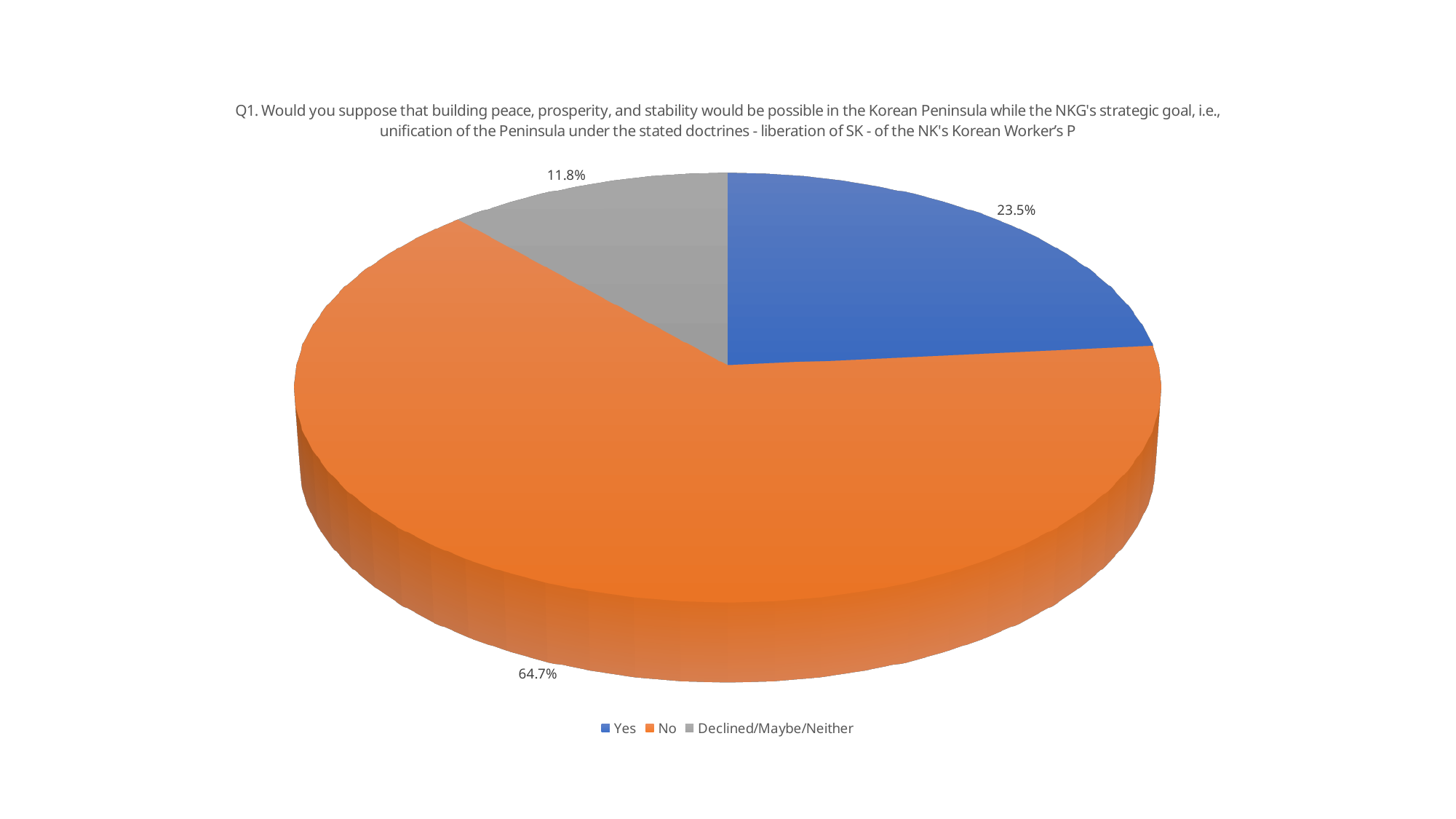
What share of the pie does the "Yes" slice represent? 23.5% What kind of chart is shown on the slide? pie chart Which is larger, the "Yes" slice or the "Declined/Maybe/Neither" slice? Yes How many slices does the pie chart have? 3 What is the difference in percentage points between the "No" slice and the "Yes" slice? 41.2 How many entries does the legend list? 3 Which category has the smallest slice of the pie? Declined/Maybe/Neither What share of the pie does the "No" slice represent? 64.7% What share of the pie does the "Declined/Maybe/Neither" slice represent? 11.8% Which category has the largest slice of the pie? No What is the difference in percentage points between the "Yes" slice and the "Declined/Maybe/Neither" slice? 11.7 What colour is the "No" slice in the pie chart? orange